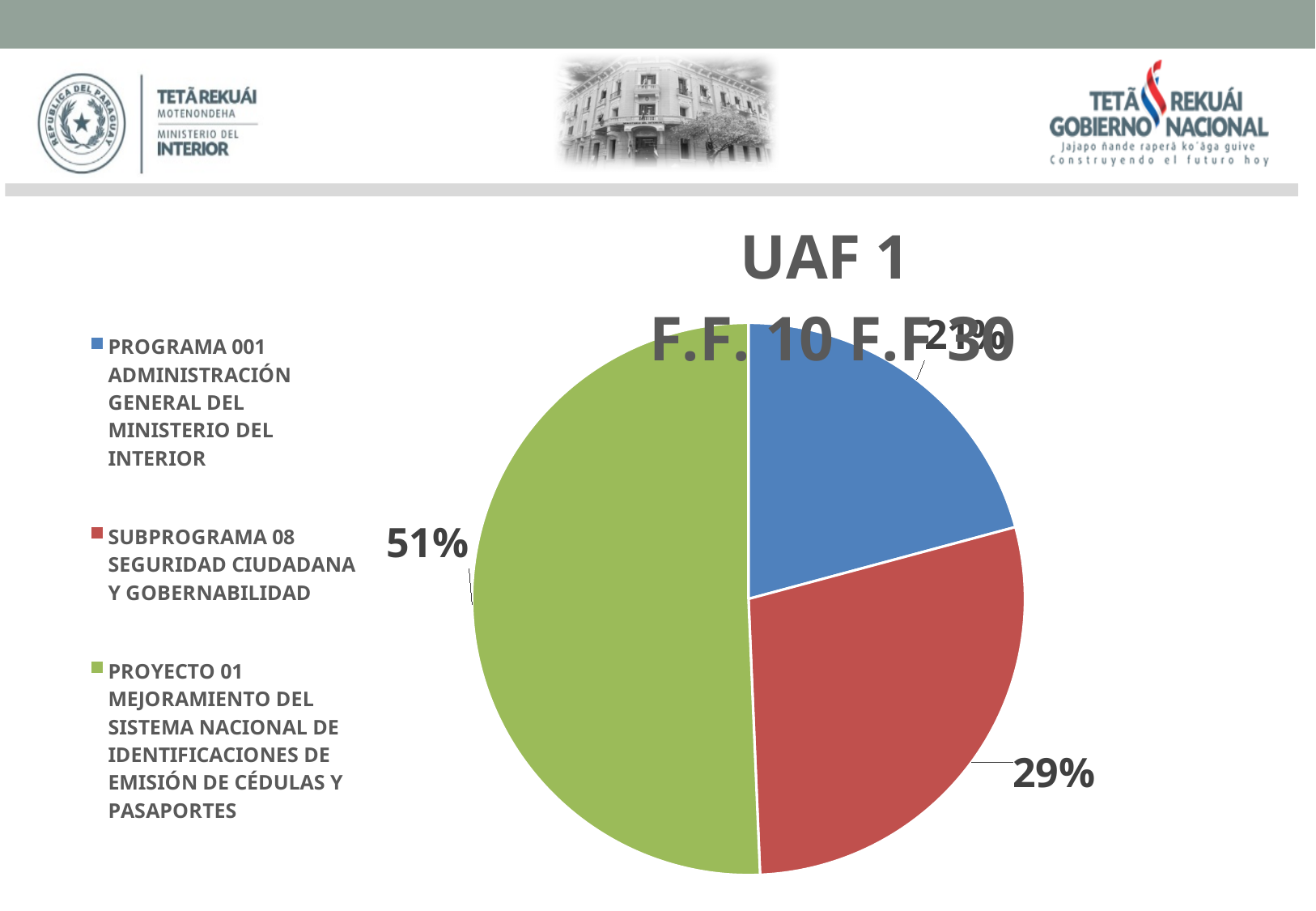
What percentage of the pie does SUBPROGRAMA 08 SEGURIDAD CIUDADANA Y GOBERNABILIDAD represent? 29% What percentage of the pie does PROYECTO 01 MEJORAMIENTO DEL SISTEMA NACIONAL DE IDENTIFICACIONES DE EMISIÓN DE CÉDULAS Y PASAPORTES represent? 51% What kind of chart is shown on the slide? Pie chart What is the title of the chart? UAF 1 F.F. 10 F.F 30 Which slice is larger: PROYECTO 01 or SUBPROGRAMA 08? PROYECTO 01 Which category has the smallest slice of the pie? PROGRAMA 001 ADMINISTRACIÓN GENERAL DEL MINISTERIO DEL INTERIOR How many categories are shown in the pie chart? 3 What colour is the slice for SUBPROGRAMA 08 SEGURIDAD CIUDADANA Y GOBERNABILIDAD? Red Which slice is larger: SUBPROGRAMA 08 or PROGRAMA 001? SUBPROGRAMA 08 Which category has the largest slice of the pie? PROYECTO 01 MEJORAMIENTO DEL SISTEMA NACIONAL DE IDENTIFICACIONES DE EMISIÓN DE CÉDULAS Y PASAPORTES Is the share for PROYECTO 01 greater or less than half of the pie? greater What is the difference in percentage points between the PROYECTO 01 slice and the SUBPROGRAMA 08 slice? 22 percentage points